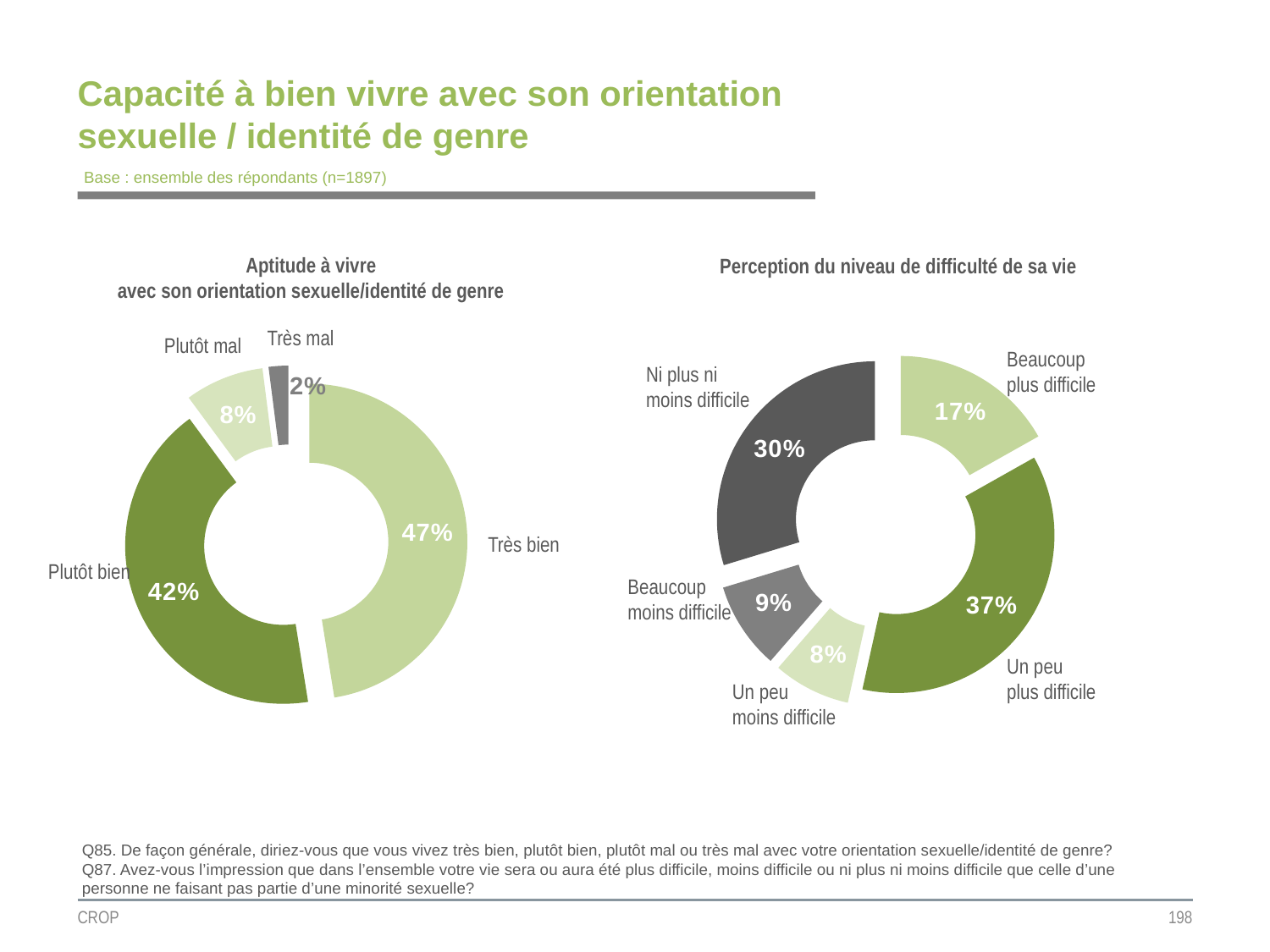
In the right chart (Perception du niveau de difficulté de sa vie), which is larger: Beaucoup plus difficile or Beaucoup moins difficile? Beaucoup plus difficile In the left chart (Aptitude à vivre avec son orientation sexuelle/identité de genre), what is the value for Plutôt mal? 8% In the left chart (Aptitude à vivre avec son orientation sexuelle/identité de genre), what is the difference between Très bien and Plutôt bien? 5% In the right chart (Perception du niveau de difficulté de sa vie), which category has the highest value? Un peu plus difficile In the left chart (Aptitude à vivre avec son orientation sexuelle/identité de genre), what is the value for Très bien? 47% In the right chart (Perception du niveau de difficulté de sa vie), what is the value for Beaucoup moins difficile? 9% In the left chart (Aptitude à vivre avec son orientation sexuelle/identité de genre), which category has the lowest value? Très mal In the right chart (Perception du niveau de difficulté de sa vie), what is the difference between Un peu plus difficile and Ni plus ni moins difficile? 7% In the left chart (Aptitude à vivre avec son orientation sexuelle/identité de genre), how many categories are shown? 4 What kind of chart is used for Perception du niveau de difficulté de sa vie? Doughnut (pie) chart In the right chart (Perception du niveau de difficulté de sa vie), what is the value for Ni plus ni moins difficile? 30% In the left chart (Aptitude à vivre avec son orientation sexuelle/identité de genre), which category has the highest value? Très bien